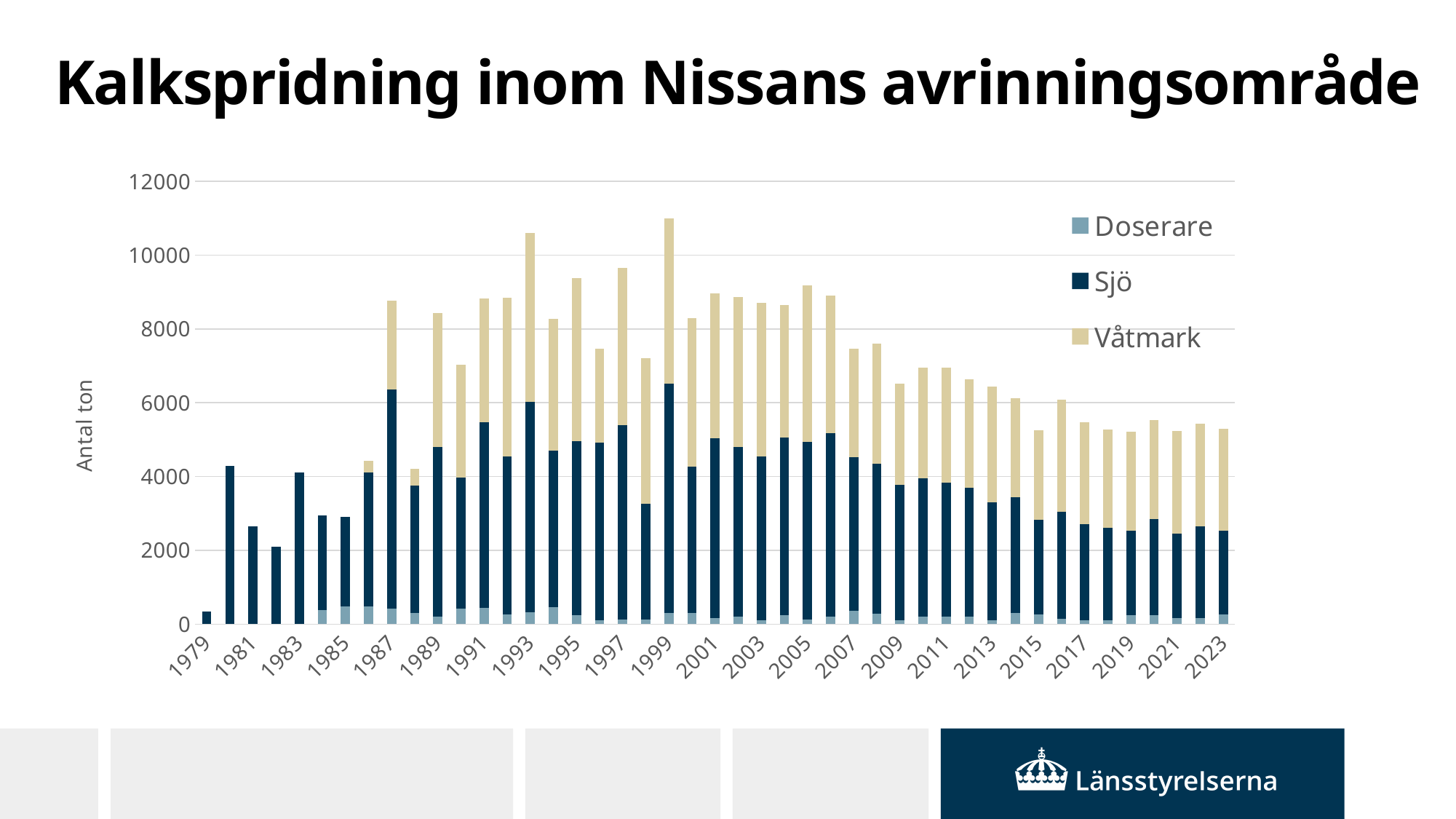
What kind of chart is shown on the slide? Stacked bar chart Is the total value for 1979 greater or less than 2000? less How many years (bars) are plotted on the x axis? 45 Do the total values generally rise or fall from 2007 to 2023? fall What is the label on the y axis? Antal ton Which year has the highest total bar? 1999 Is the total value for 1999 greater or less than 10000? greater Which year has the lowest total bar? 1979 What is the title of the chart? Kalkspridning inom Nissans avrinningsområde Is the total value for 2023 greater or less than 4000? greater How many series does the legend list? 3 Which year has the larger total bar, 1979 or 1981? 1981